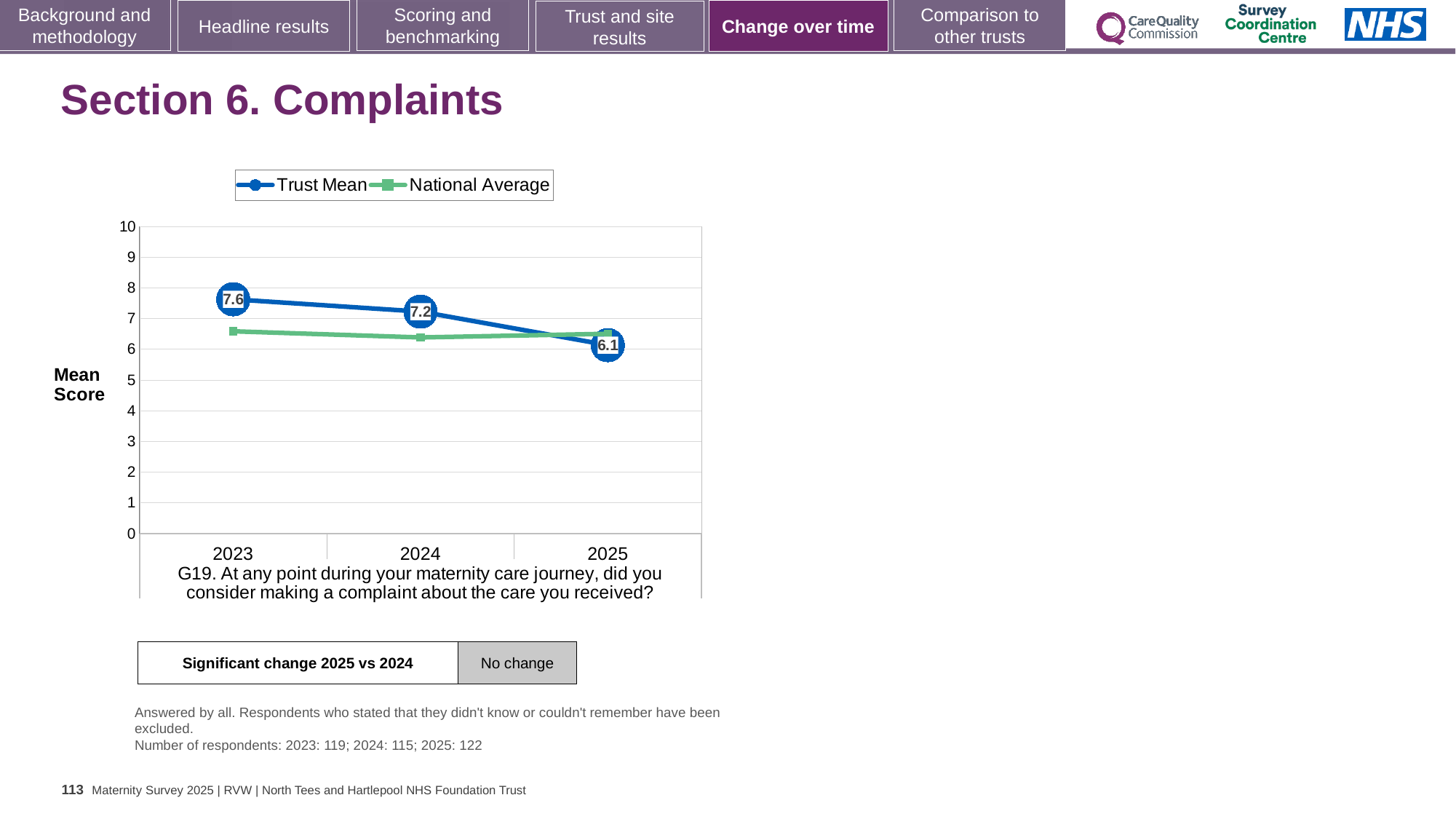
What kind of chart is shown on the slide? Line chart Is the National Average value for 2024 greater or less than 7? less In 2023, which is larger: the Trust Mean or the National Average? Trust Mean In which year is the Trust Mean score lowest? 2025 What is the Trust Mean score for 2023? 7.6 How many years are shown on the x axis? 3 How many series does the legend list? 2 What is the difference between the Trust Mean score in 2023 and in 2025? 1.5 In which year is the Trust Mean score highest? 2023 Is the National Average value for 2023 greater or less than 6? greater What is the Trust Mean score for 2025? 6.1 What is the Trust Mean score for 2024? 7.2